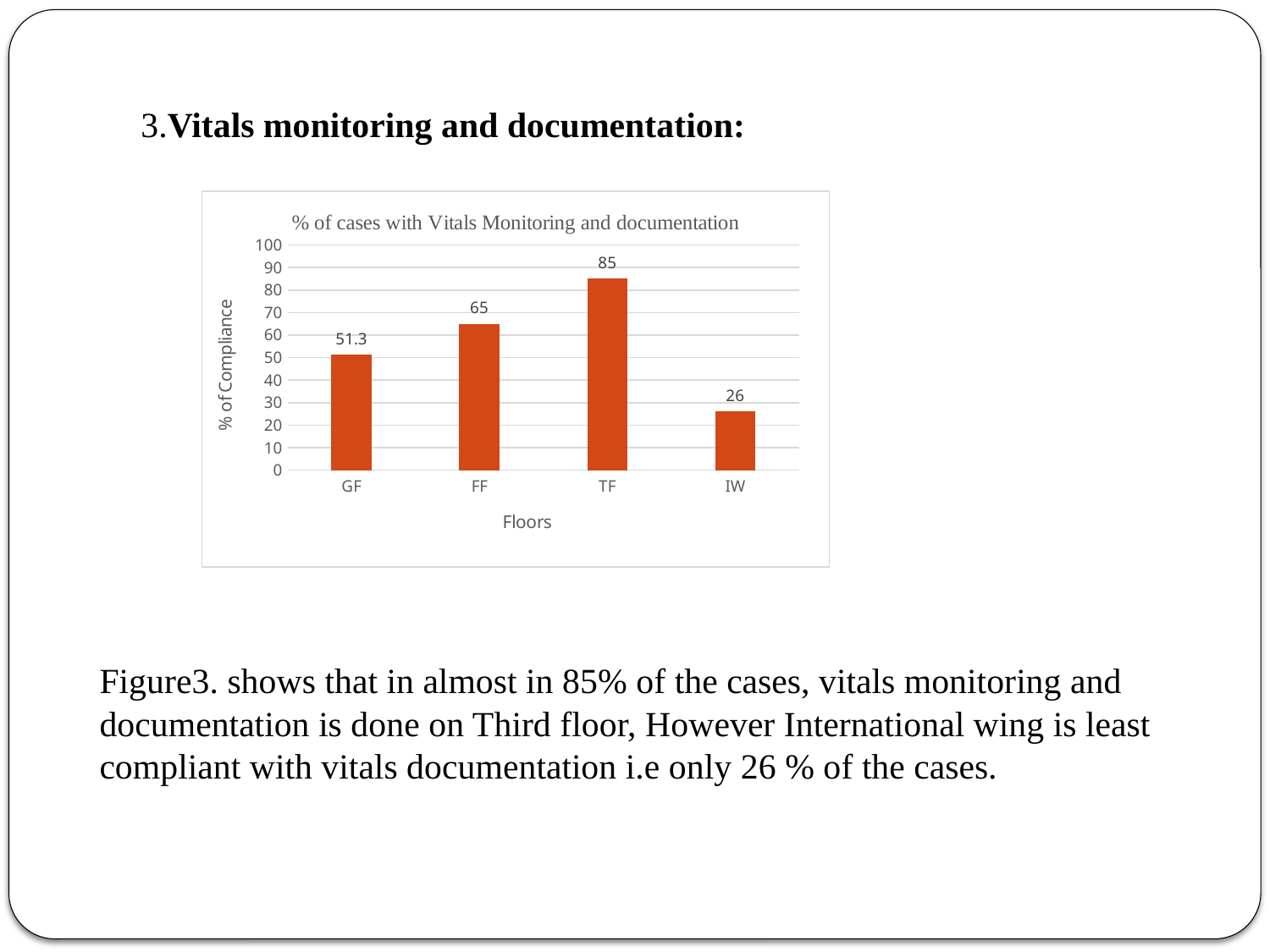
Which floor has the highest % of compliance? TF What is the difference between the values for FF and GF? 13.7 What is the difference between the values for TF and IW? 59 What is the value for IW? 26 What is the title of the chart? % of cases with Vitals Monitoring and documentation What kind of chart is shown? bar chart How many floors are shown on the x axis? 4 What is the value for TF? 85 Which floor has the lowest % of compliance? IW Is the value for IW greater or less than 30? less What is the value for GF? 51.3 Which is larger, the value for FF or the value for GF? FF